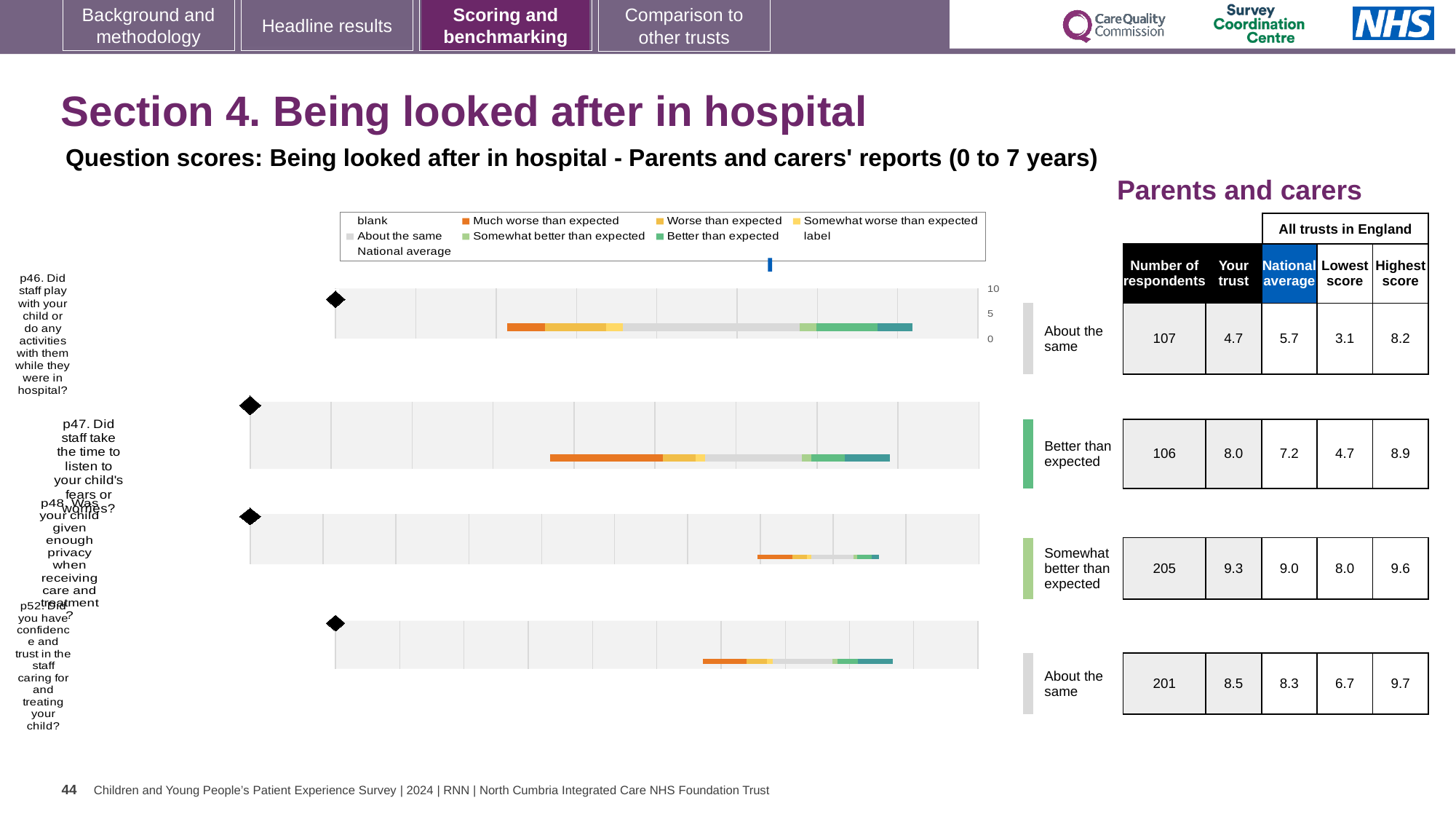
What kind of chart is used for each question on this slide? bar chart How many question charts (p46, p47, p48, p52) are shown on the slide? 4 What is the difference between the 'Your trust' score and the national average for p47 in the table? 0.8 In the legend, what colour represents 'Much worse than expected'? orange In the table beside the p46 chart, what is the 'Your trust' score? 4.7 Which question has the lowest 'Your trust' score in the table: p46, p47, p48 or p52? p46 In the table beside the p48 chart, how many respondents are listed? 205 What is the highest value shown on the vertical axis of the p46 chart? 10 In the table beside the p52 chart, what is the highest score among all trusts in England? 9.7 Which question has the highest 'Your trust' score in the table: p46, p47, p48 or p52? p48 What benchmark label is shown next to the p47 chart? Better than expected In the table beside the p47 chart, what is the national average score? 7.2